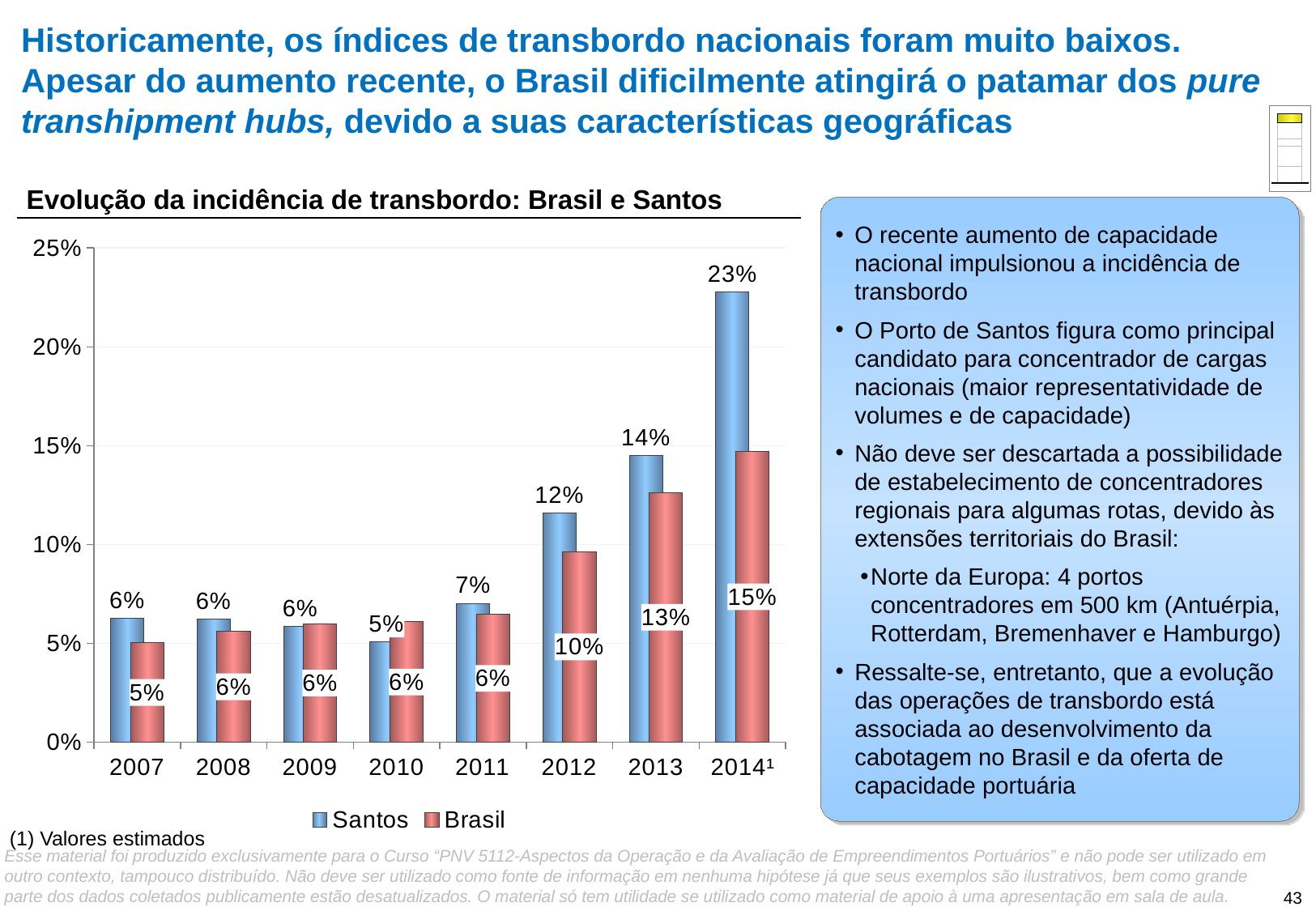
What is the value for Brasil in 2007? 5% What is the value for Santos in 2011? 7% What is the difference between the Santos and Brasil values in 2014¹? 8% How many years are shown on the x axis? 8 Does the Santos value rise or fall from 2011 to 2014¹? Rise In which year is the Santos value lowest? 2010 What is the value for Santos in 2014¹? 23% What is the value for Brasil in 2013? 13% How many series does the legend list? 2 What kind of chart is shown? Bar chart Which is larger in 2012, the Santos value or the Brasil value? Santos In which year is the Santos value highest? 2014¹